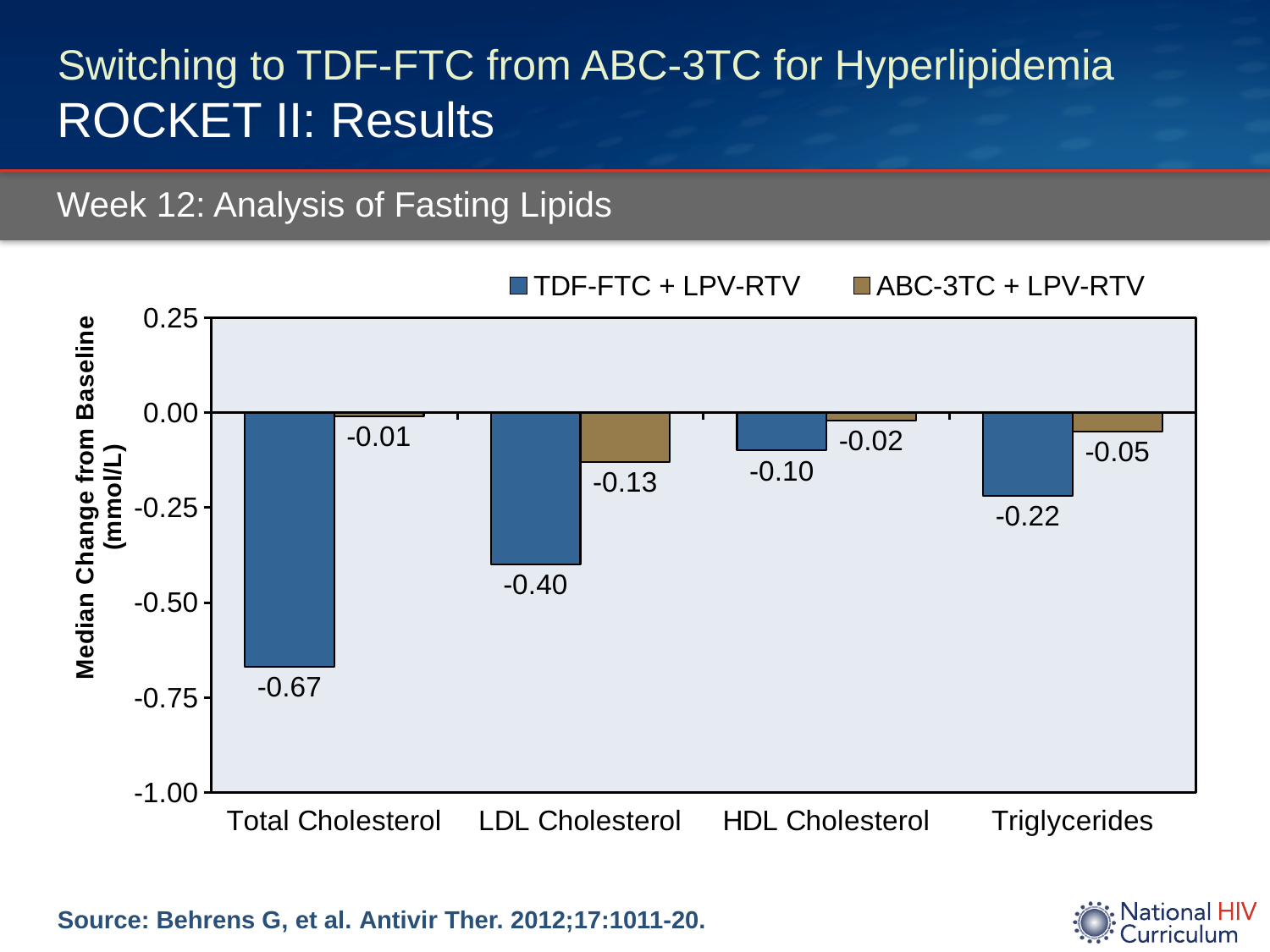
Which lipid category shows the smallest change from baseline for the ABC-3TC + LPV-RTV group? Total Cholesterol What is the label of the y axis? Median Change from Baseline (mmol/L) What is the median change from baseline in LDL Cholesterol for the ABC-3TC + LPV-RTV group? -0.13 Which group shows a larger decrease in Triglycerides, TDF-FTC + LPV-RTV or ABC-3TC + LPV-RTV? TDF-FTC + LPV-RTV What is the median change from baseline in Triglycerides for the TDF-FTC + LPV-RTV group? -0.22 What is the median change from baseline in Total Cholesterol for the TDF-FTC + LPV-RTV group? -0.67 What kind of chart is shown on the slide? Bar chart How many series does the legend list? 2 How many lipid categories are shown on the x axis? 4 Which lipid category shows the largest decrease from baseline for the TDF-FTC + LPV-RTV group? Total Cholesterol What is the difference between the TDF-FTC + LPV-RTV and ABC-3TC + LPV-RTV median changes for LDL Cholesterol? 0.27 What is the median change from baseline in HDL Cholesterol for the ABC-3TC + LPV-RTV group? -0.02